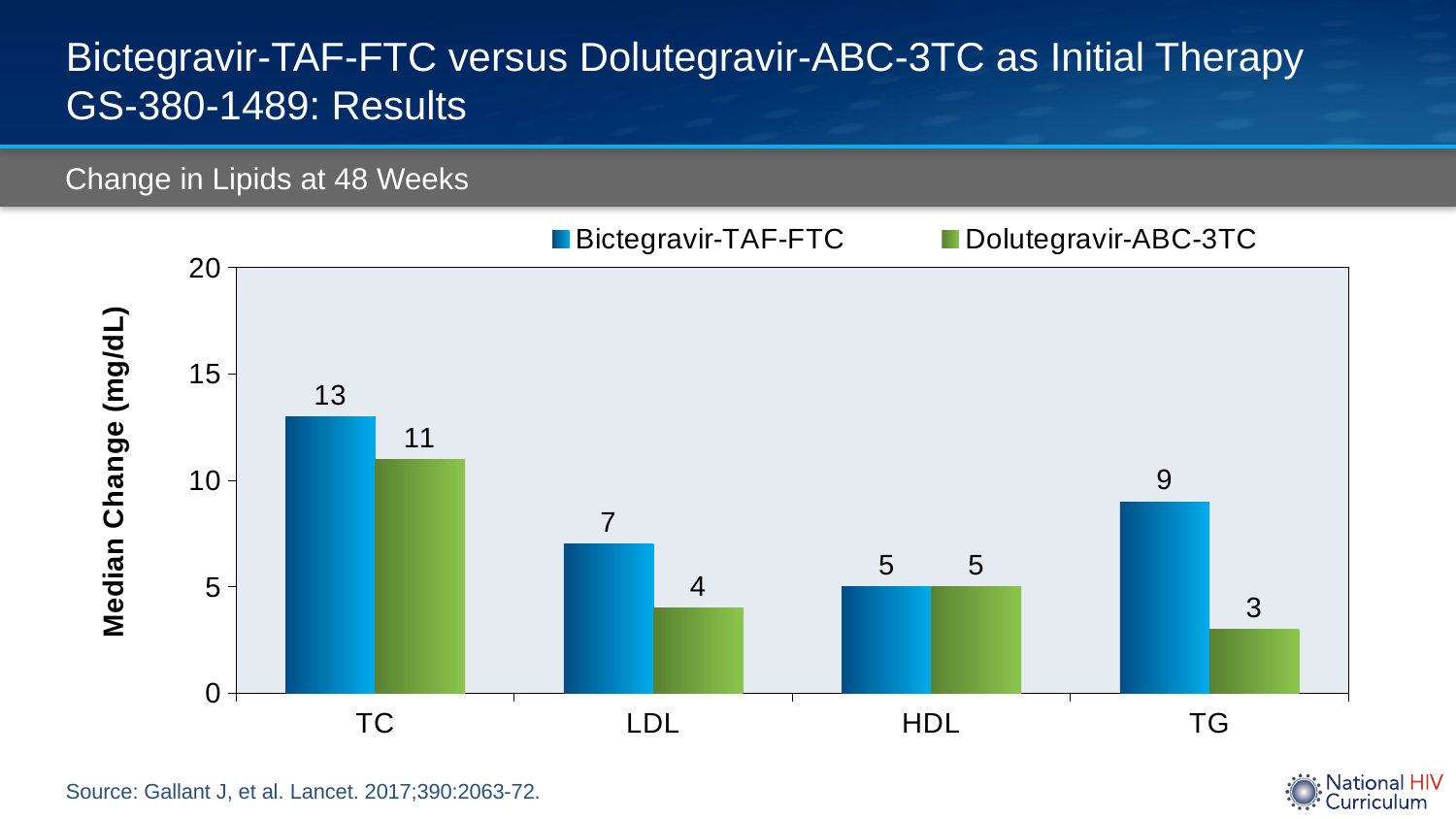
What is the median change in TC for Bictegravir-TAF-FTC? 13 Is the Bictegravir-TAF-FTC value for TC greater or less than 10? greater Which lipid category has the highest median change for Dolutegravir-ABC-3TC? TC What is the median change in LDL for Dolutegravir-ABC-3TC? 4 How many lipid categories are shown on the x axis? 4 What is the difference between the Bictegravir-TAF-FTC and Dolutegravir-ABC-3TC values for TG? 6 What is the median change in TG for Bictegravir-TAF-FTC? 9 For LDL, which regimen has the larger median change? Bictegravir-TAF-FTC What is the label of the y axis? Median Change (mg/dL) Which lipid category has the lowest median change for Dolutegravir-ABC-3TC? TG What kind of chart is shown on the slide? bar chart How many series does the legend list? 2